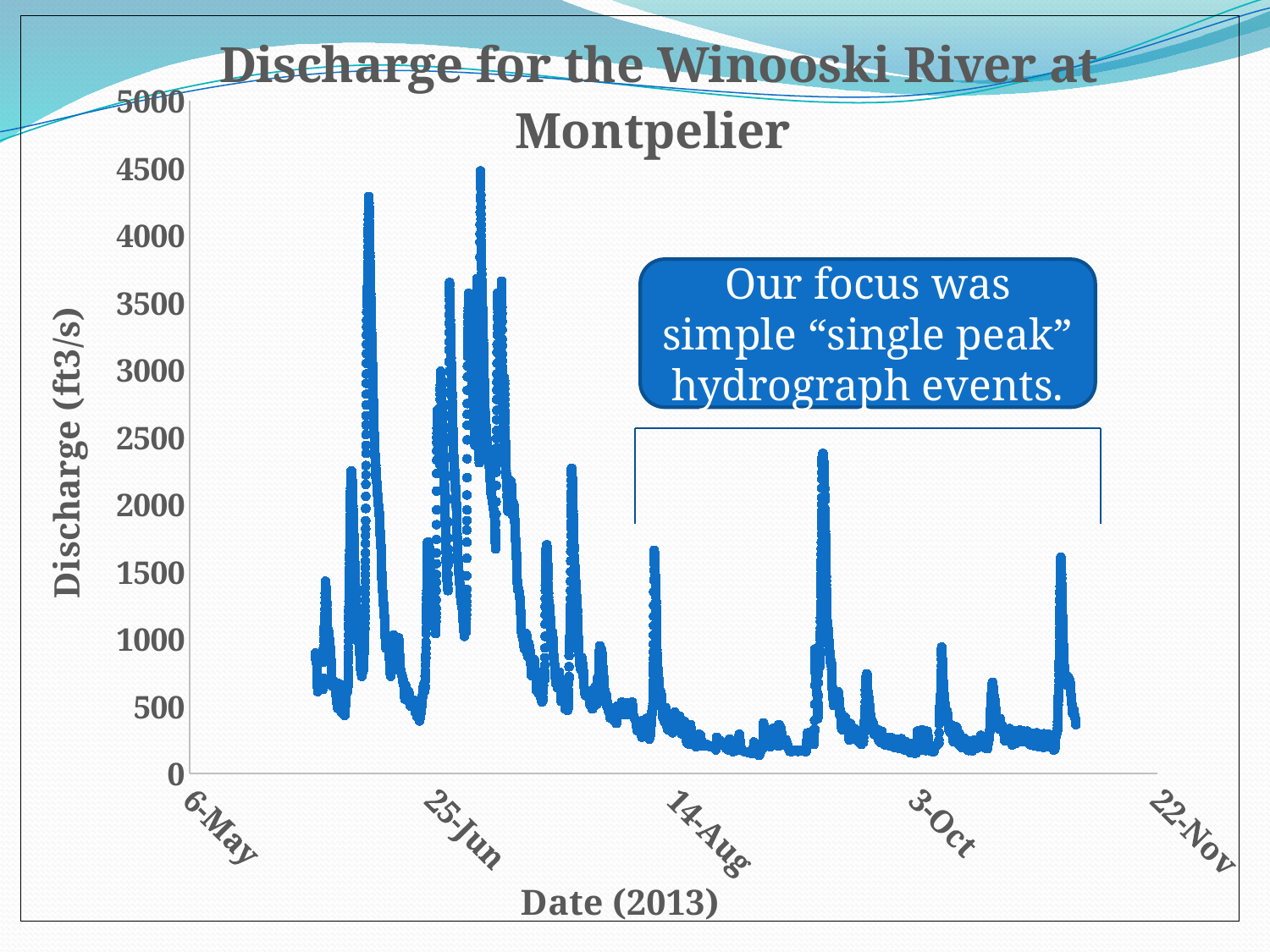
What is the label of the y-axis? Discharge (ft3/s) What is the title of the chart? Discharge for the Winooski River at Montpelier Is the highest discharge peak on the chart greater or less than 4000 ft3/s? greater What is the highest value shown on the y-axis? 5000 Which period has the higher discharge peaks: around 25-Jun or around 3-Oct? around 25-Jun Does the discharge generally rise or fall between late June and late August? fall Is the discharge peak that occurs between 3-Oct and 22-Nov greater or less than 1000 ft3/s? greater Is the discharge peak that occurs between 14-Aug and 3-Oct greater or less than 2000 ft3/s? greater How many date labels are shown on the x-axis? 5 What kind of chart is shown on the slide? scatter chart